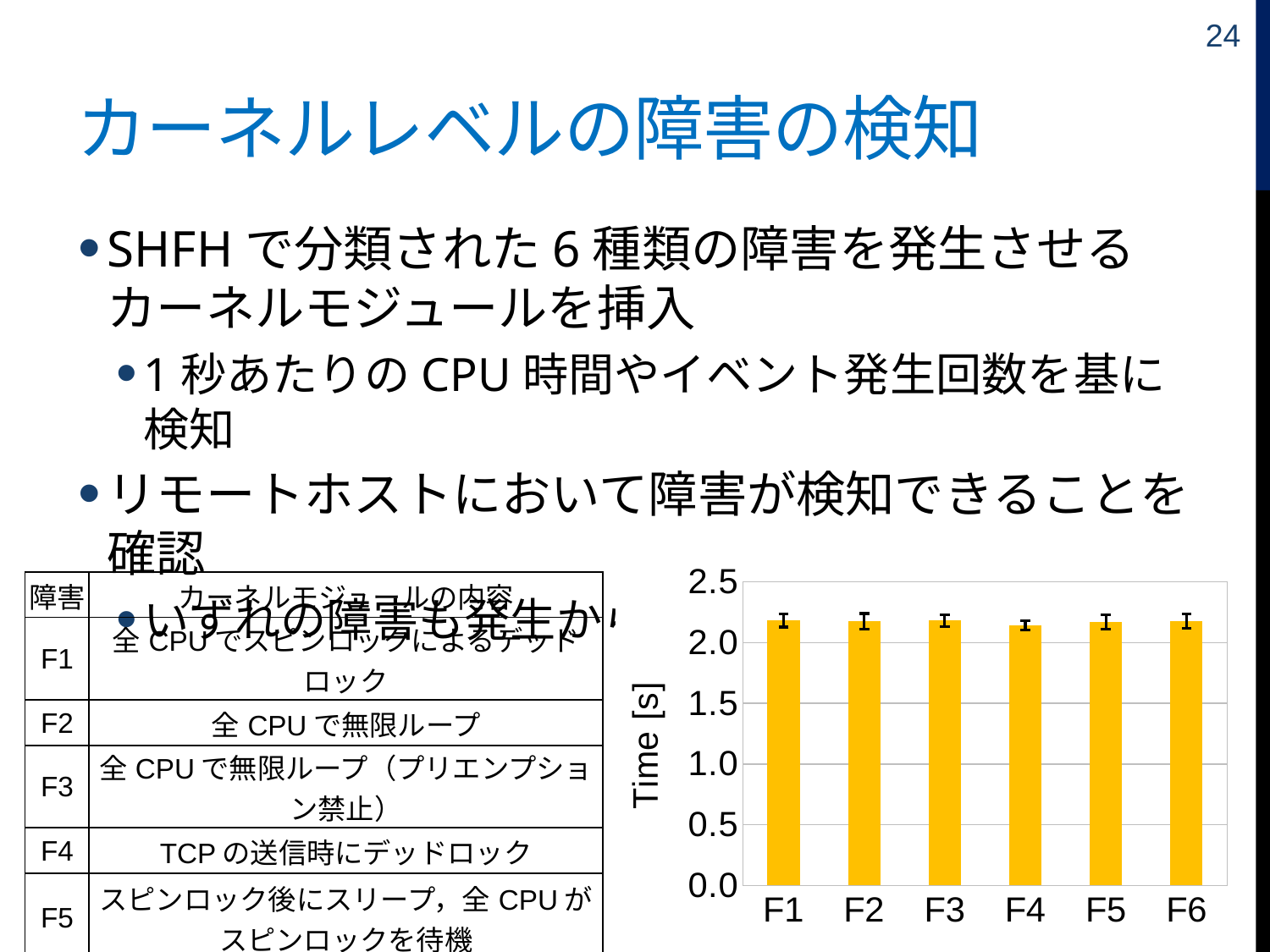
Is the value for F6 greater or less than 1.5? greater Is the value for F2 greater or less than 2.5? less Is the value for F4 greater or less than 2.5? less What is the label of the y axis of the bar chart? Time [s] What is the highest tick value shown on the y axis of the bar chart? 2.5 What kind of chart is shown on the slide? bar chart How many categories are shown on the x axis of the bar chart? 6 What is the label of the first category on the x axis of the bar chart? F1